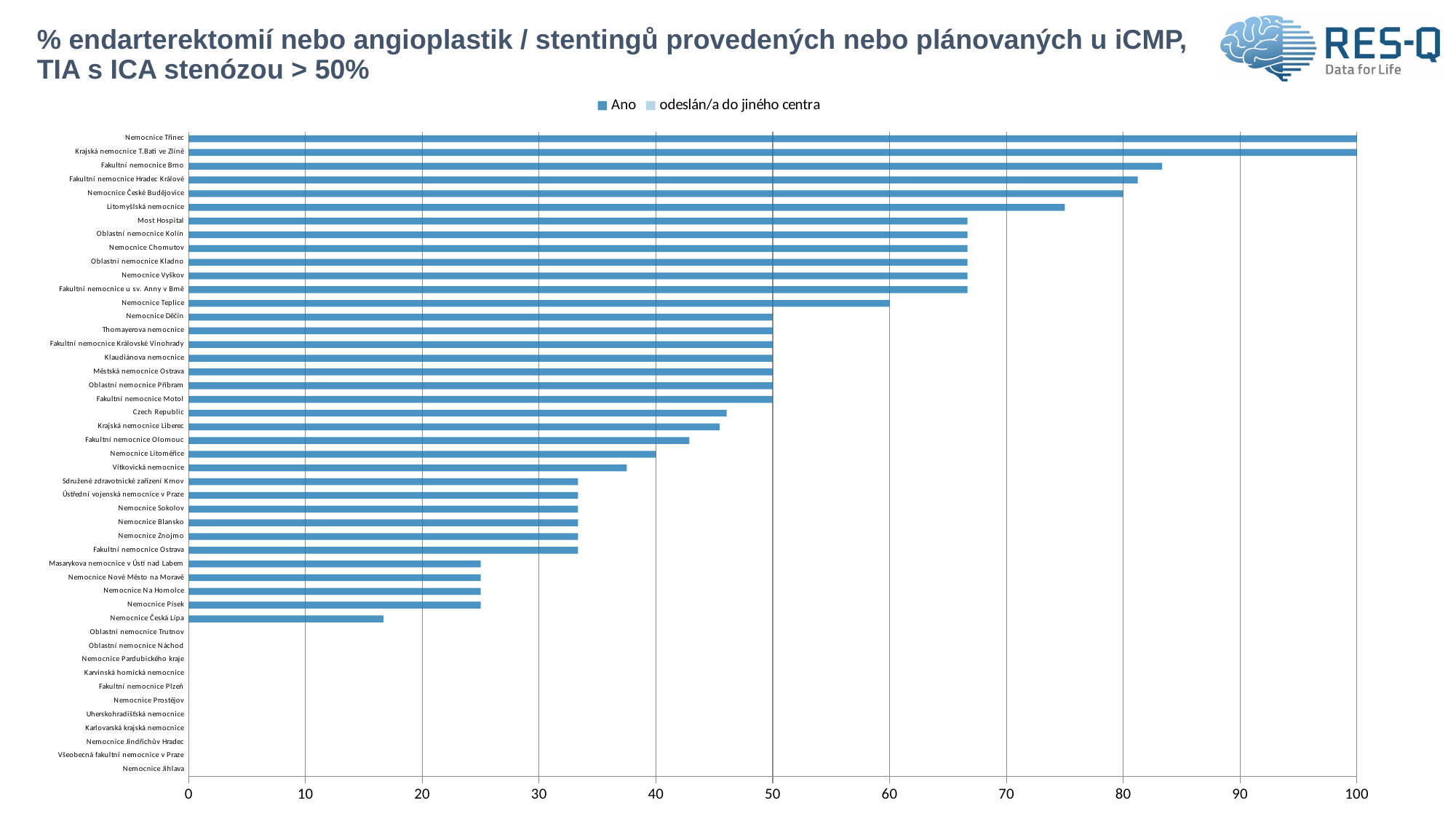
Is the value for Litomyšlská nemocnice greater or less than 70? greater What is the value for Nemocnice Litoměřice? 40 What is the value for Nemocnice České Budějovice? 80 What kind of chart is shown on the slide? bar chart What is the value for Nemocnice Teplice? 60 What is the value for Fakultní nemocnice Motol? 50 How many series does the legend list? 2 Is the value for Nemocnice Česká Lípa greater or less than 20? less What are the two series names listed in the legend? Ano; odeslán/a do jiného centra Which is larger, the value for Fakultní nemocnice Brno or the value for Nemocnice Teplice? Fakultní nemocnice Brno Is the value for Fakultní nemocnice Brno greater or less than 80? greater What is the value for Nemocnice Třinec? 100